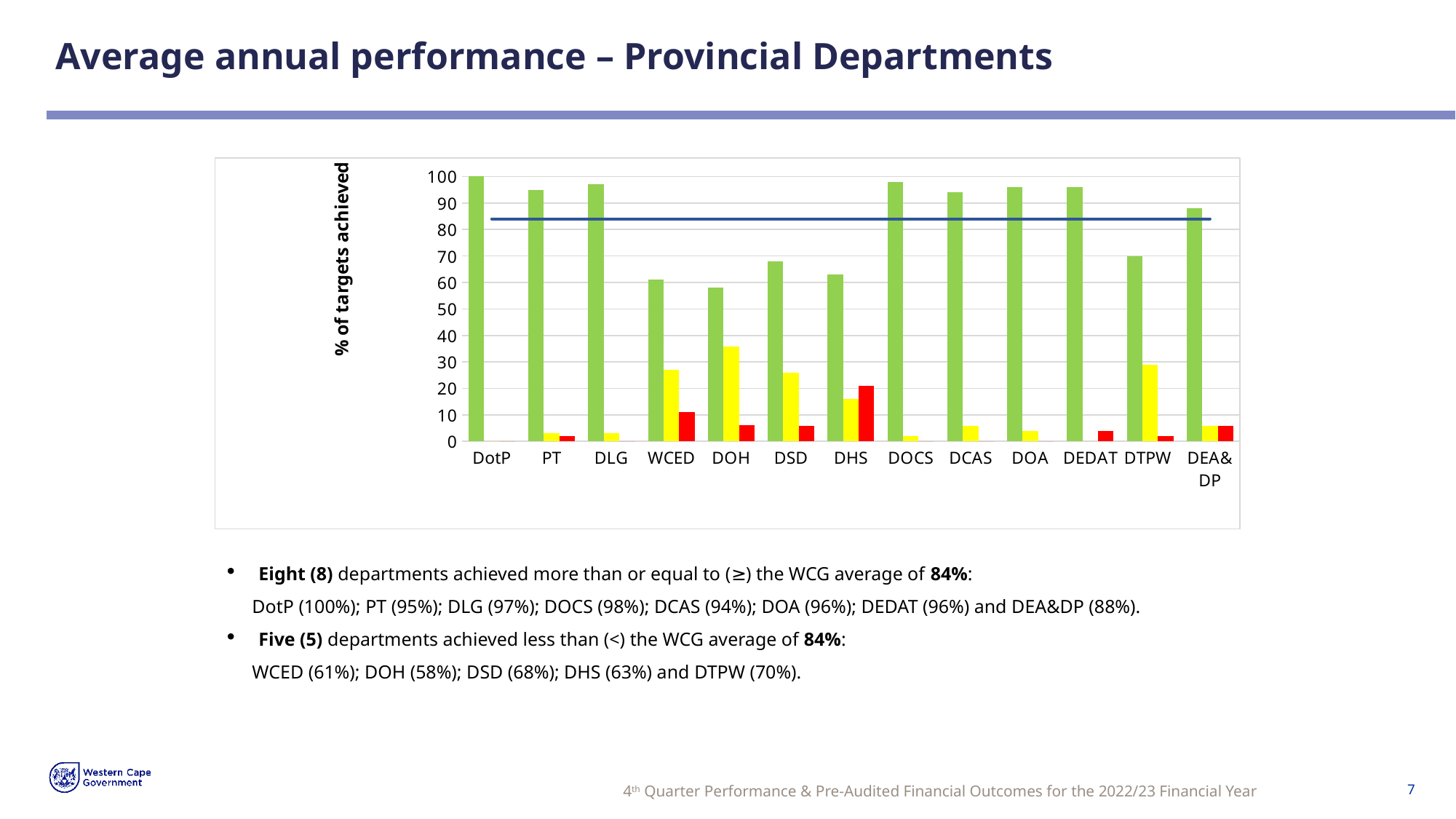
What is the value of the green bar for DTPW? 70 Is the green bar for DOCS greater or less than 90? greater Which department has the tallest yellow bar? DOH How many departments are shown along the x axis of the chart? 13 What is the label on the vertical axis of the chart? % of targets achieved Which has the taller green bar, DSD or DHS? DSD Which department has the tallest green bar in the chart? DotP Which department has the tallest red bar? DHS Which department has the lowest green bar in the chart? DOH What is the value of the green bar for DotP? 100 Is the green bar for WCED greater or less than 70? less What kind of chart is shown on the slide? combination bar and line chart